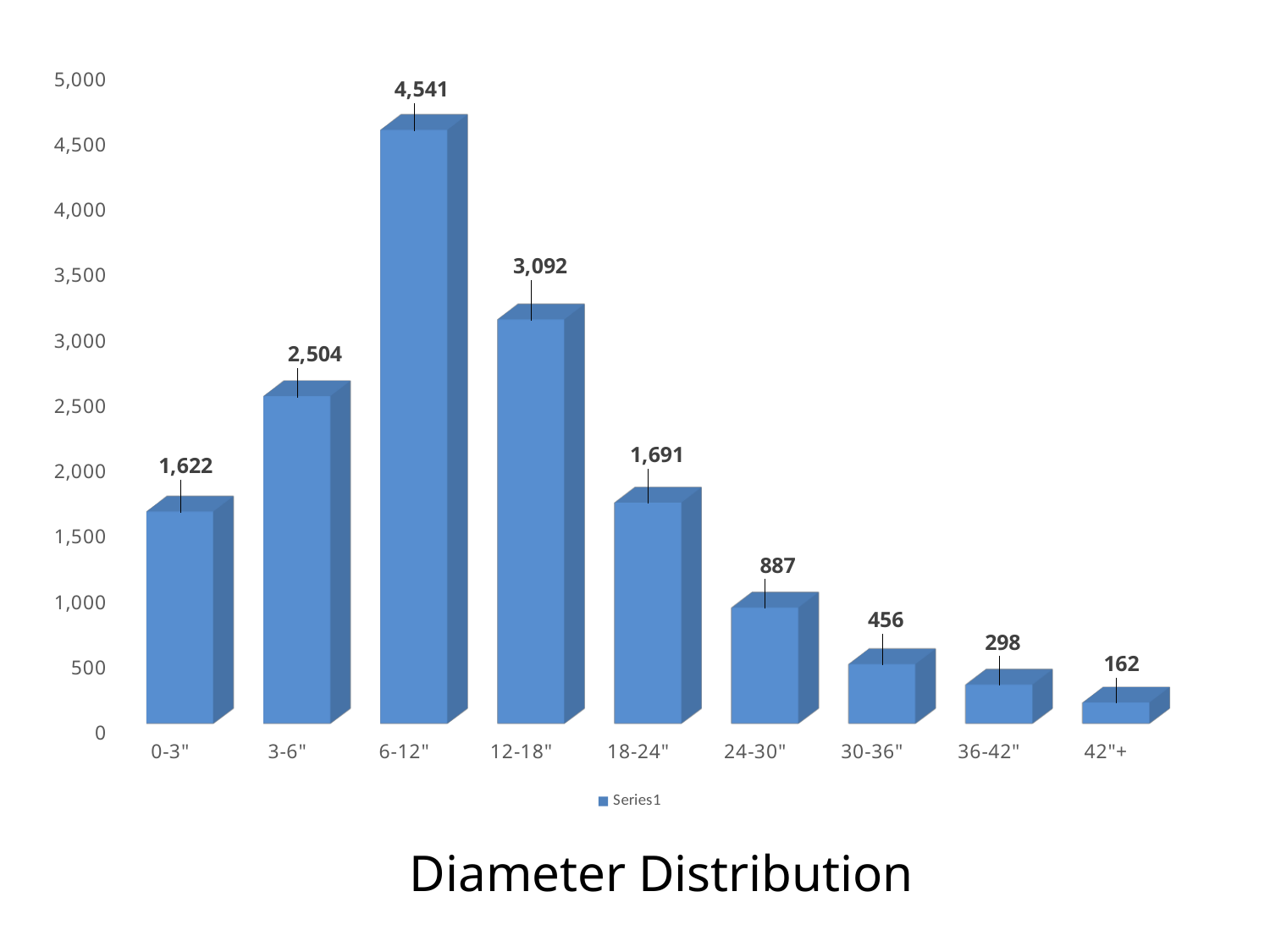
What is the value for the 6-12" category? 4,541 Which category has the highest value? 6-12" Which category has the lowest value? 42"+ What is the difference between the values for 6-12" and 12-18"? 1,449 What is the value for the 42"+ category? 162 What is the title of the chart? Diameter Distribution Is the value for 30-36" greater or less than 500? less Which is larger, the value for 3-6" or the value for 18-24"? 3-6" What is the difference between the values for 0-3" and 18-24"? 69 How many categories are shown on the x axis? 9 What kind of chart is shown on the slide? bar chart What is the value for the 24-30" category? 887